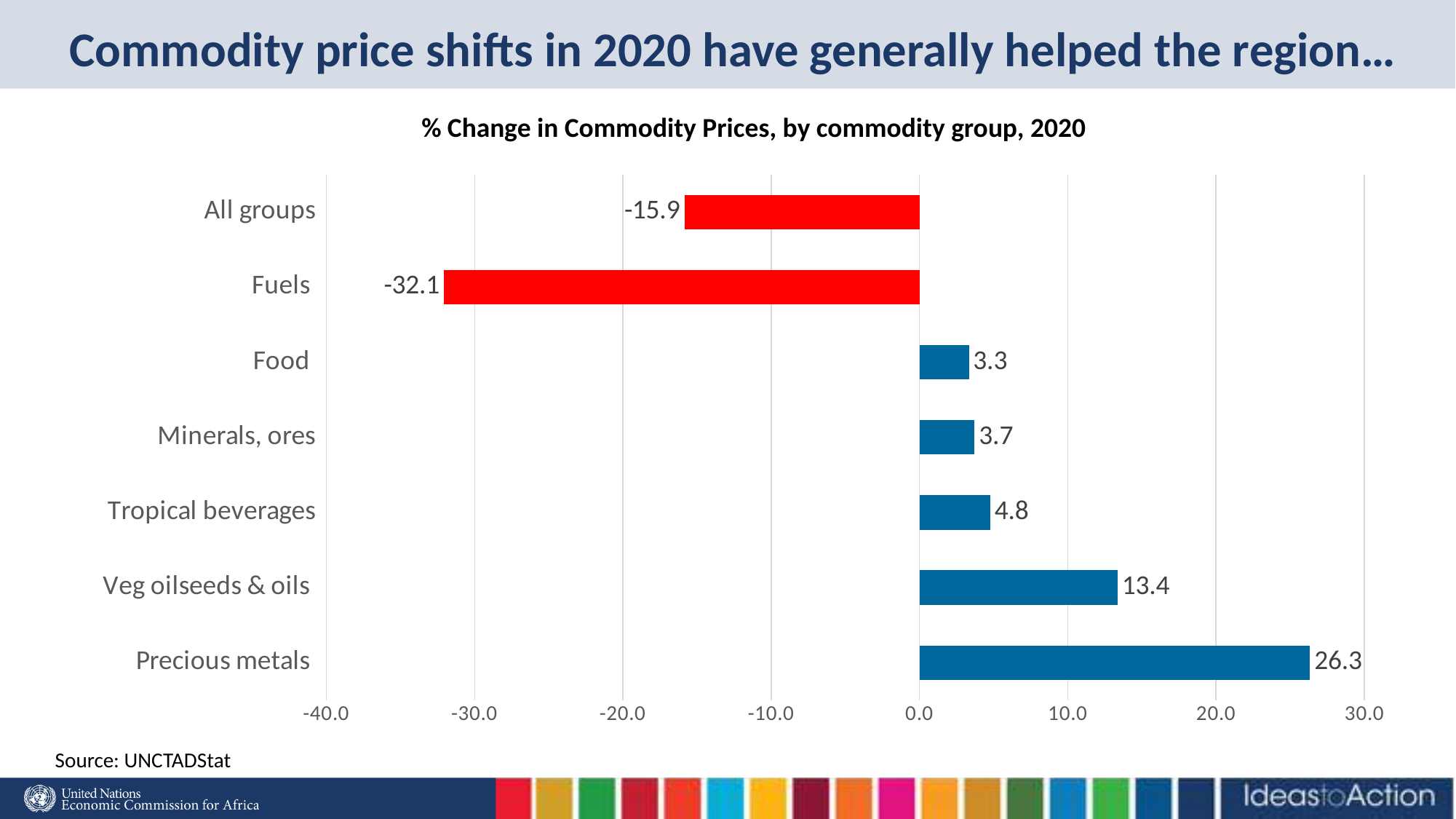
How many commodity groups are shown on the chart? 7 What kind of chart is shown on the slide? Bar chart What is the title of the chart? % Change in Commodity Prices, by commodity group, 2020 What is the % change in commodity prices for Precious metals? 26.3 What is the difference between the values for Precious metals and Veg oilseeds & oils? 12.9 What is the value shown for All groups? -15.9 What is the % change in commodity prices for Fuels in 2020? -32.1 What is the value shown for Veg oilseeds & oils? 13.4 Which has a larger % change, Food or Tropical beverages? Tropical beverages Which commodity group has the highest % change in prices? Precious metals What colour are the bars for the groups with negative values? Red Which commodity group has the lowest % change in prices? Fuels